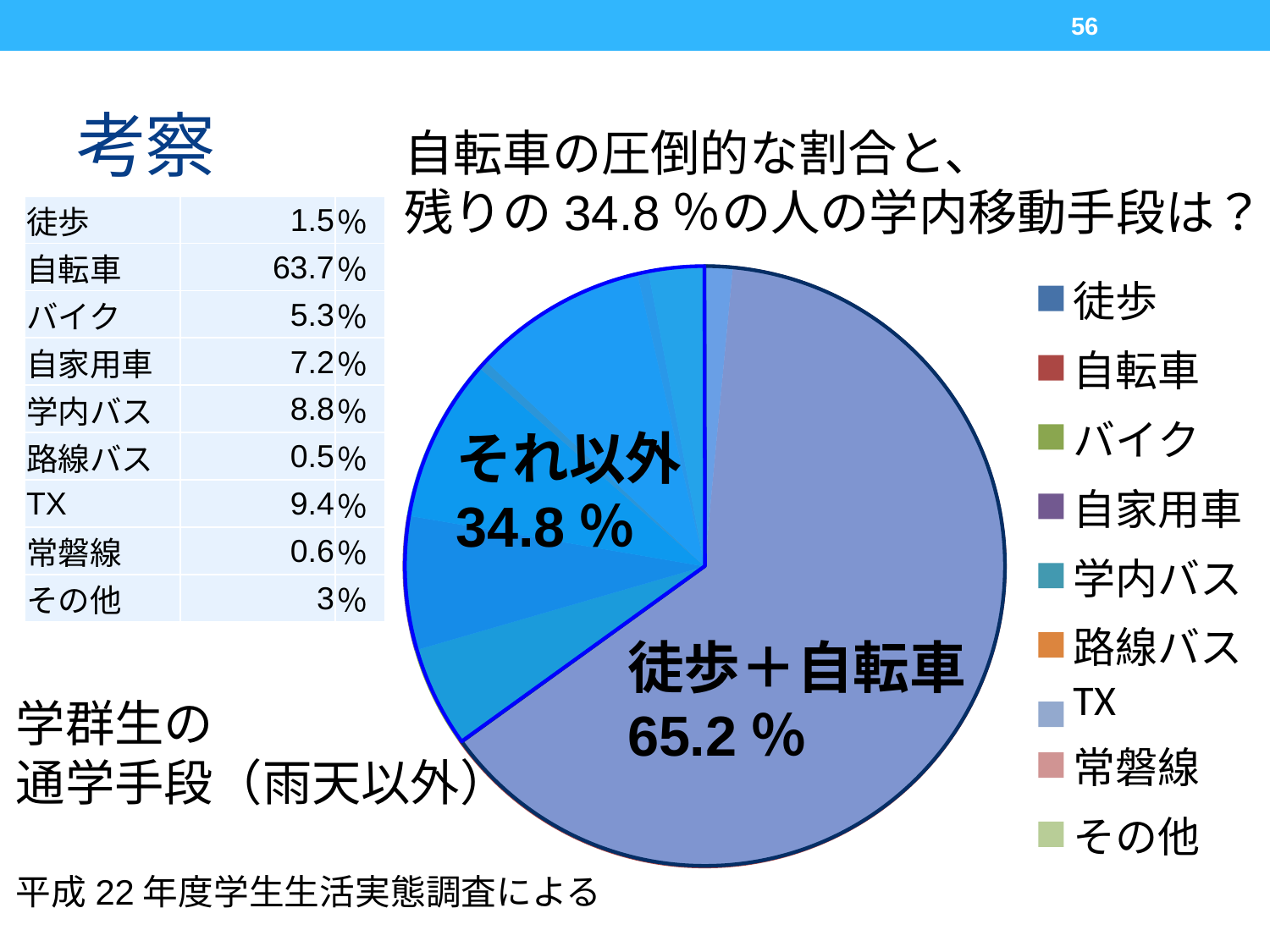
What combined share of the pie is labelled for 徒歩＋自転車? 65.2% What is the caption given for the pie chart at the lower left of the slide? 学群生の通学手段（雨天以外） Which category has the smallest share of the pie? 路線バス Which has a larger share, TX or 学内バス? TX What share of the pie is labelled それ以外? 34.8% How many categories does the legend of the pie chart list? 9 What is the total of the 徒歩 and 自転車 percentages from the table? 65.2% Which category has the largest share of the pie? 自転車 What is the difference between the percentages for 学内バス and 自家用車? 1.6% What kind of chart is shown on the slide? pie chart What percentage is shown for 自転車 in the table next to the pie chart? 63.7% What percentage is shown for TX? 9.4%